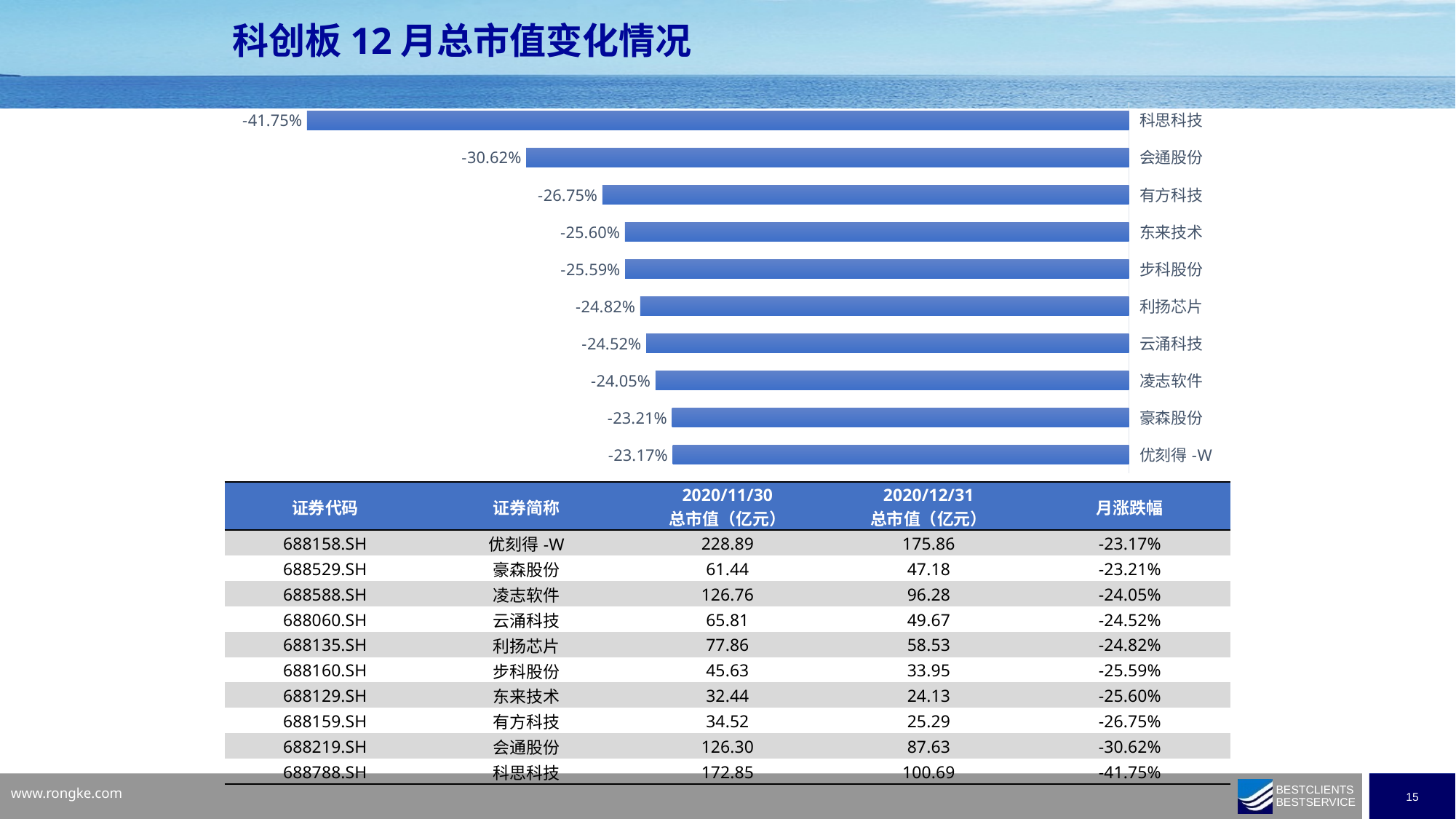
What is the value shown for 优刻得 -W in the bar chart? -23.17% What is the title of the slide containing the chart? 科创板 12 月总市值变化情况 Do the values become more negative or less negative going from the top bar to the bottom bar? Less negative Which category has the highest (least negative) value in the bar chart? 优刻得 -W What is the value shown for 会通股份 in the bar chart? -30.62% What is the difference in percentage points between the values for 科思科技 and 会通股份? 11.13 percentage points Which has the larger value, 有方科技 or 东来技术? 东来技术 Which category has the lowest (most negative) value in the bar chart? 科思科技 What kind of chart is shown on the slide? Bar chart What is the value shown for 凌志软件 in the bar chart? -24.05% How many categories are shown in the bar chart? 10 What is the value shown for 科思科技 in the bar chart? -41.75%